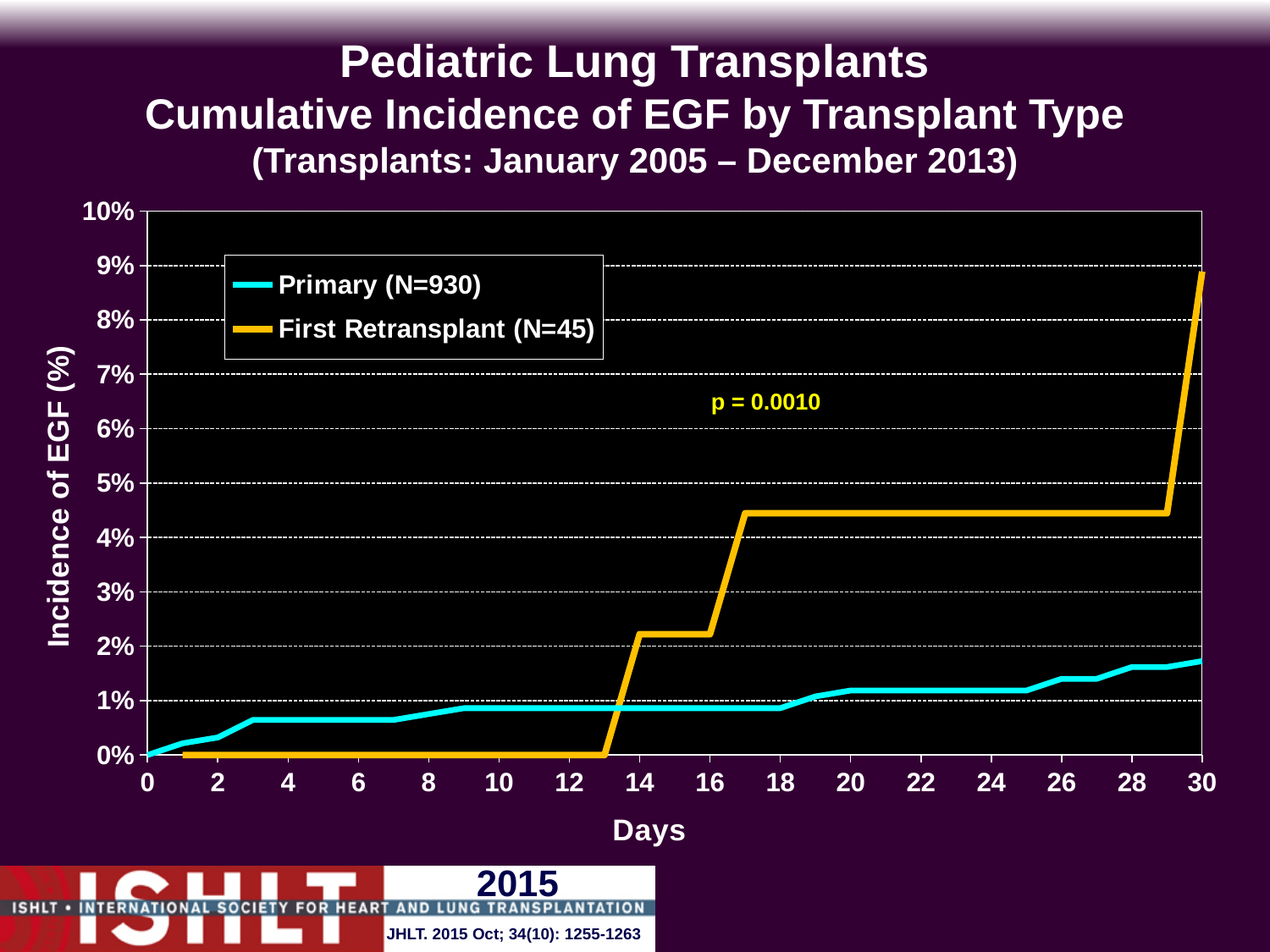
Is the value for Primary at day 30 greater or less than 1%? greater Is the value for First Retransplant at day 30 greater or less than 8%? greater Is the value for Primary at day 30 greater or less than 2%? less How many series does the legend list? 2 What are the two series named in the legend? Primary (N=930) and First Retransplant (N=45) What kind of chart is shown on the slide? line chart Does the First Retransplant line rise or fall as days increase from 0 to 30? rise What p-value is printed on the chart? p = 0.0010 At day 30, which series has the higher cumulative incidence of EGF, Primary or First Retransplant? First Retransplant